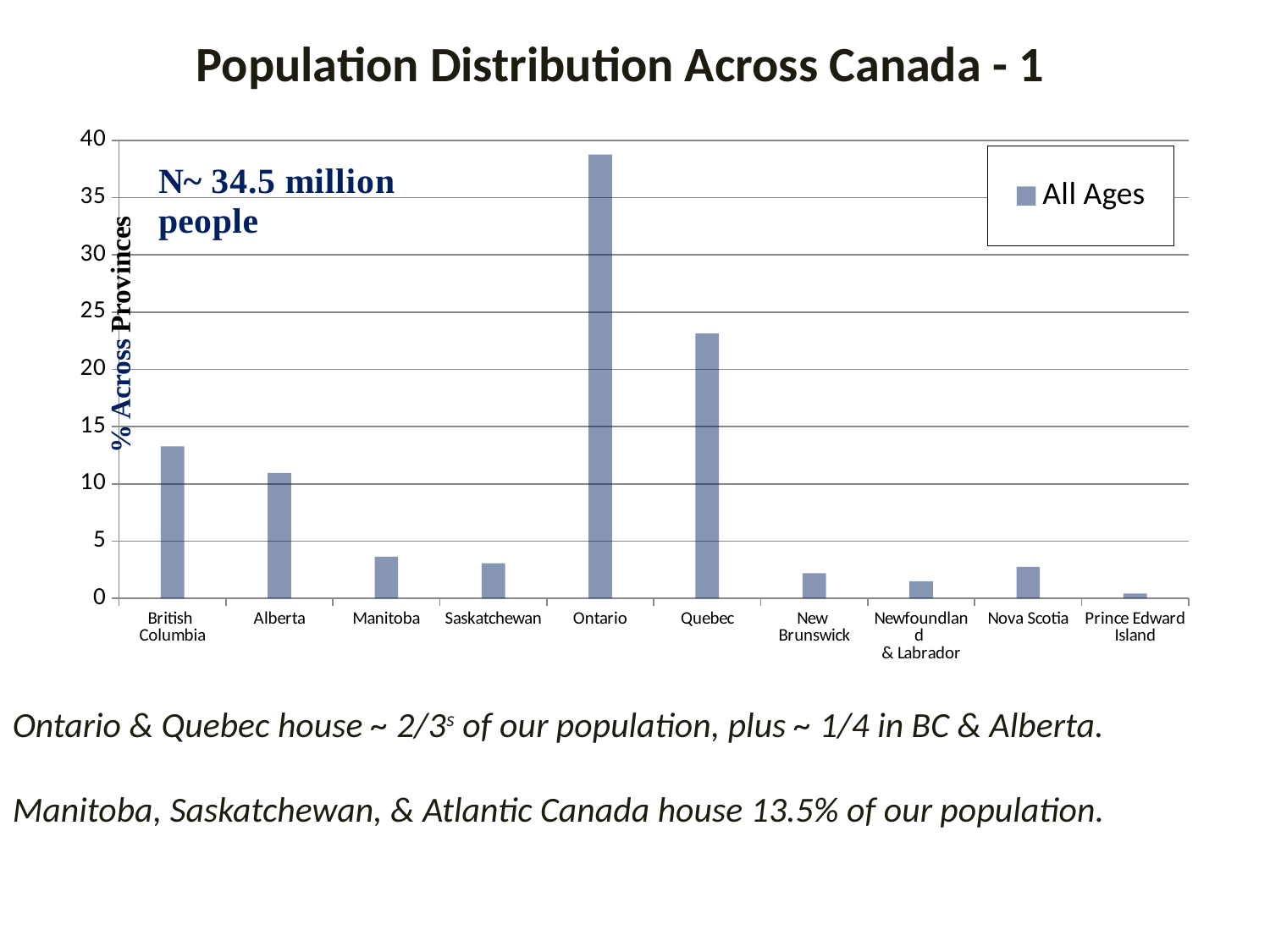
What kind of chart is shown on the slide? bar chart Which province has the highest value in the chart? Ontario Is the value for British Columbia greater or less than 10? greater Which province has the lowest value in the chart? Prince Edward Island What is the label of the series shown in the legend? All Ages Is the value for Manitoba greater or less than 5? less Is the value for Ontario greater or less than 35? greater Which has the larger value, Alberta or Manitoba? Alberta How many series does the legend list? 1 How many provinces are shown on the x axis of the chart? 10 Which has the larger value, Quebec or British Columbia? Quebec